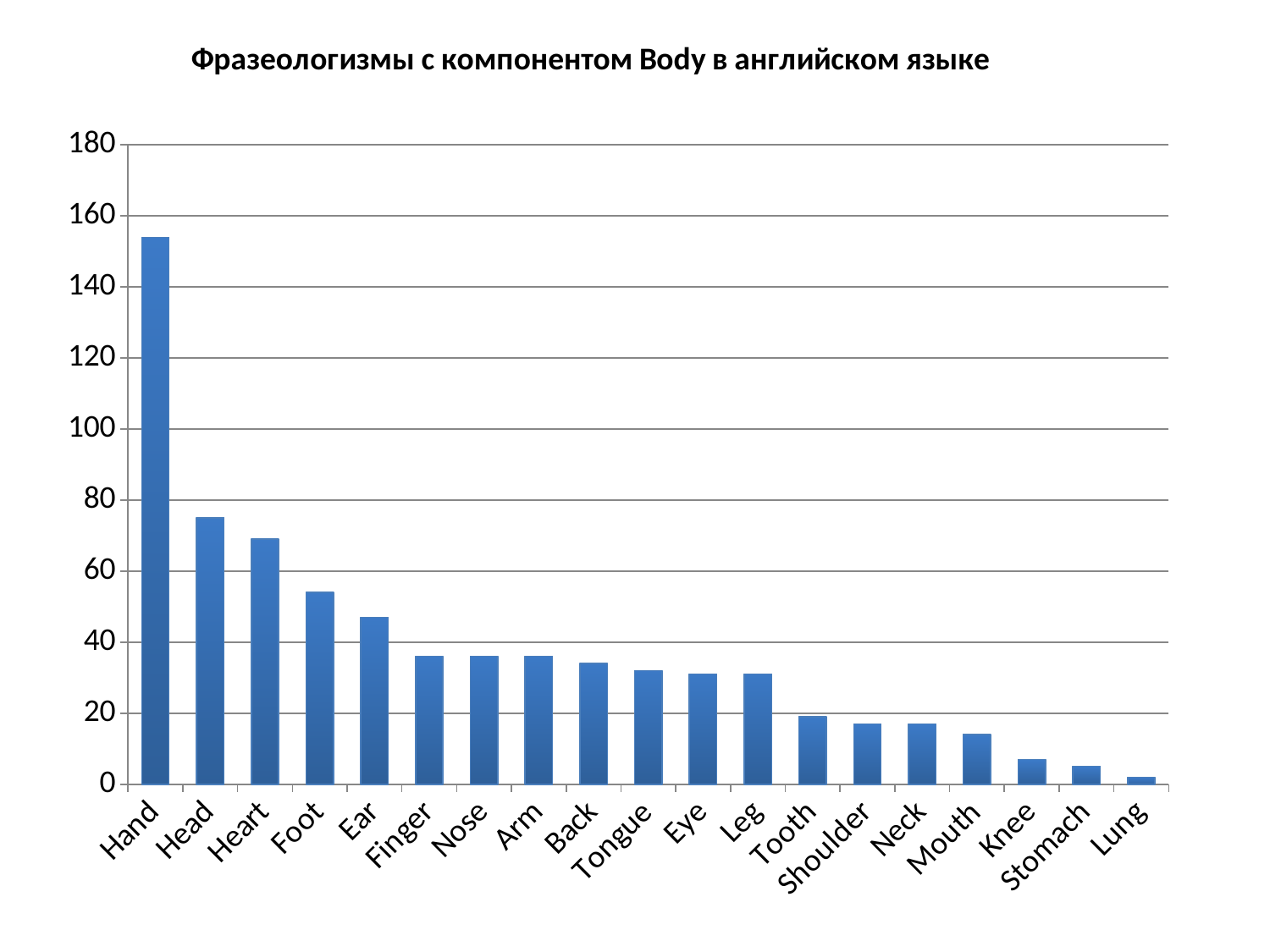
Is the value for Heart greater or less than 60? greater Which is larger, the value for Foot or the value for Ear? Foot Is the value for Mouth greater or less than 20? less Which category has the lowest value? Lung What is the title of the chart? Фразеологизмы с компонентом Body в английском языке What kind of chart is shown on the slide? bar chart Is the value for Head greater or less than 80? less Which category has the highest value? Hand How many categories are shown on the x axis? 19 Do the values generally rise or fall from left to right along the x axis? fall